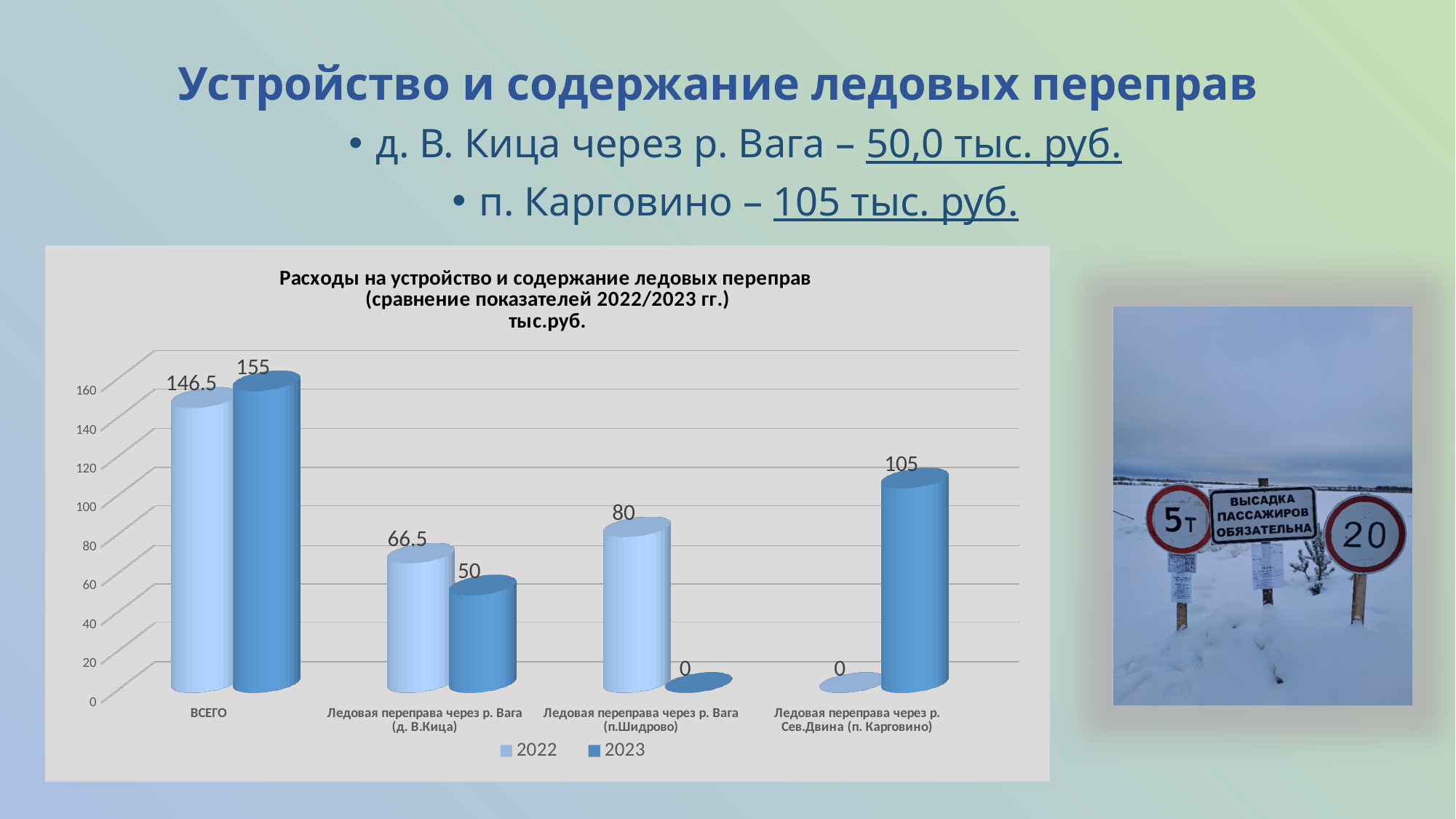
What kind of chart is shown on the slide? Bar chart How many categories are shown on the x axis? 4 What is the 2022 value for Ледовая переправа через р. Вага (д. В.Кица)? 66.5 What is the 2023 value for Ледовая переправа через р. Сев.Двина (п. Карговино)? 105 What is the 2023 value for ВСЕГО? 155 What is the 2022 value for ВСЕГО? 146.5 For ВСЕГО, which year has the larger value, 2022 or 2023? 2023 Excluding ВСЕГО, which category has the lowest 2022 value? Ледовая переправа через р. Сев.Двина (п. Карговино) Which category has the highest 2023 value? ВСЕГО How many series does the legend list? 2 What is the difference between the 2022 and 2023 values for Ледовая переправа через р. Вага (д. В.Кица)? 16.5 What is the 2023 value for Ледовая переправа через р. Вага (п.Шидрово)? 0